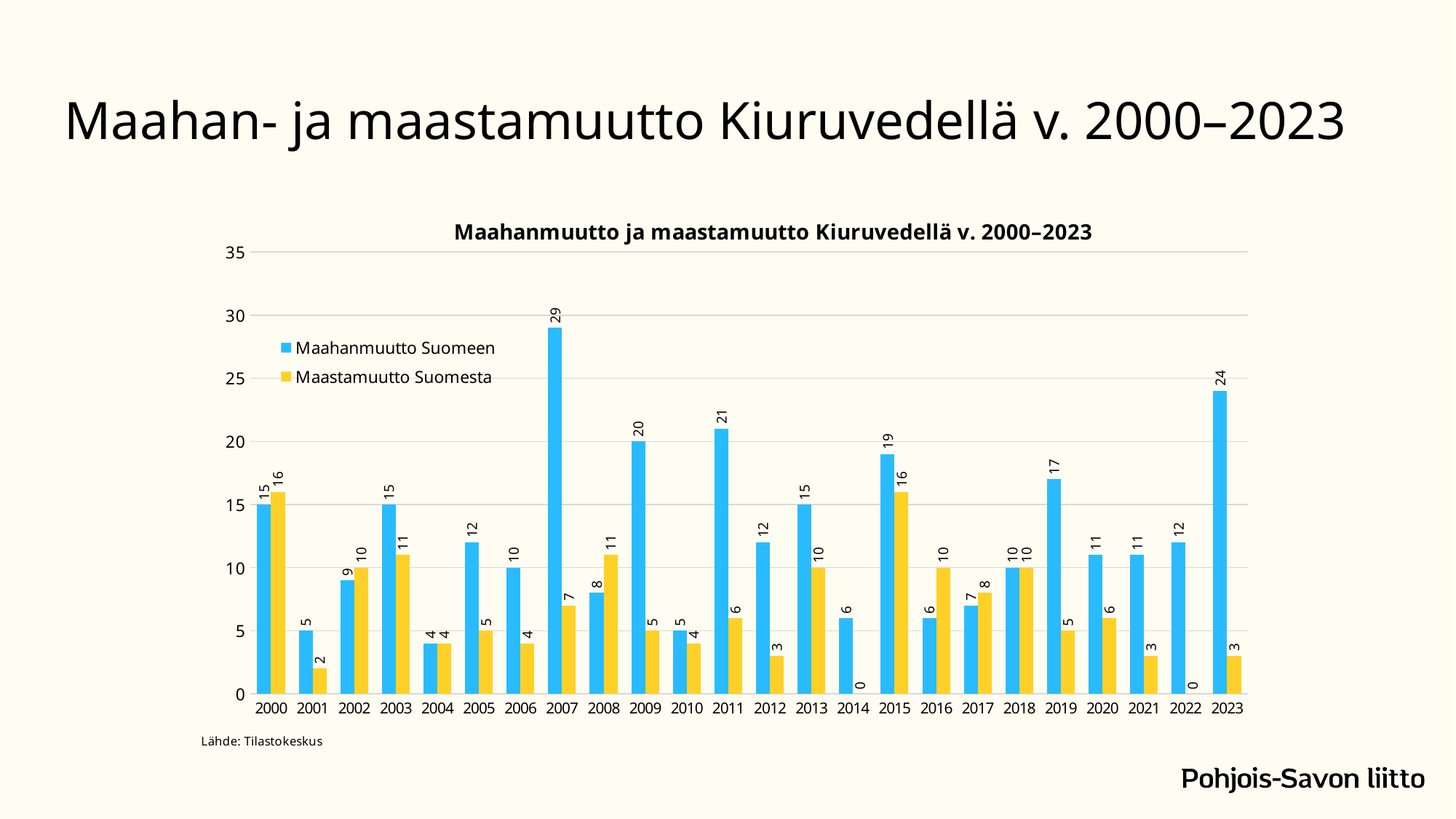
What is the value of Maastamuutto Suomesta in 2015? 16 How many years are shown on the x axis? 24 What kind of chart is shown on the slide? Bar chart Which is larger in 2016, Maahanmuutto Suomeen or Maastamuutto Suomesta? Maastamuutto Suomesta What is the difference between Maahanmuutto Suomeen and Maastamuutto Suomesta in 2007? 22 What is the source cited below the chart? Tilastokeskus What is the value of Maahanmuutto Suomeen in 2007? 29 Which year has the lowest value for Maahanmuutto Suomeen? 2004 What is the value of Maahanmuutto Suomeen in 2023? 24 Which year has the highest value for Maahanmuutto Suomeen? 2007 How many series does the legend list? 2 Is the value for Maahanmuutto Suomeen in 2011 greater or less than 20? greater